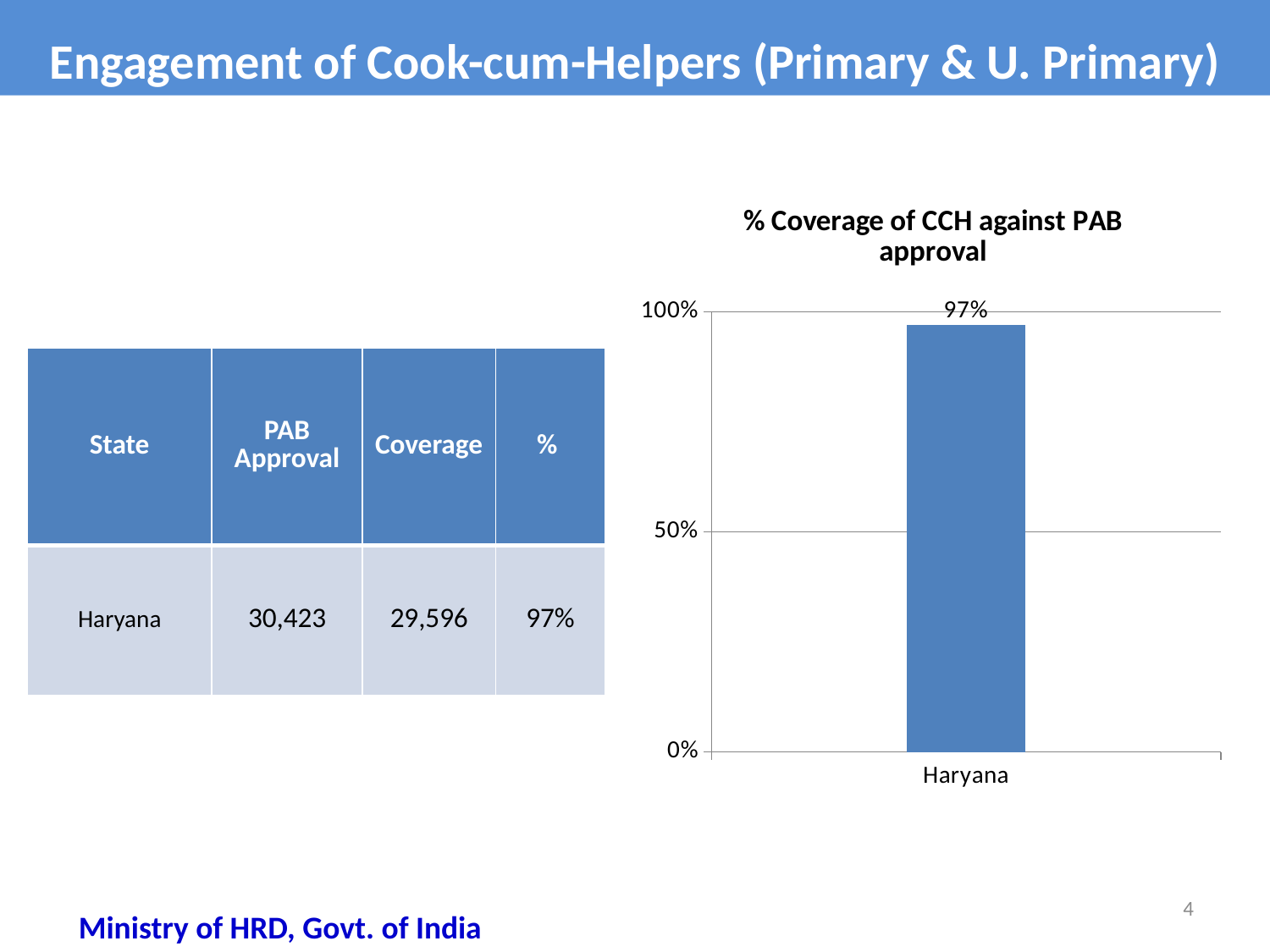
Which state is shown on the x axis of the chart? Haryana How many categories are plotted in the chart? 1 What is the value for Haryana in the chart? 97% What is the title of the chart? % Coverage of CCH against PAB approval What is the highest value shown on the y axis of the chart? 100% Is the value for Haryana greater or less than 50%? greater What kind of chart is shown on the slide? bar chart